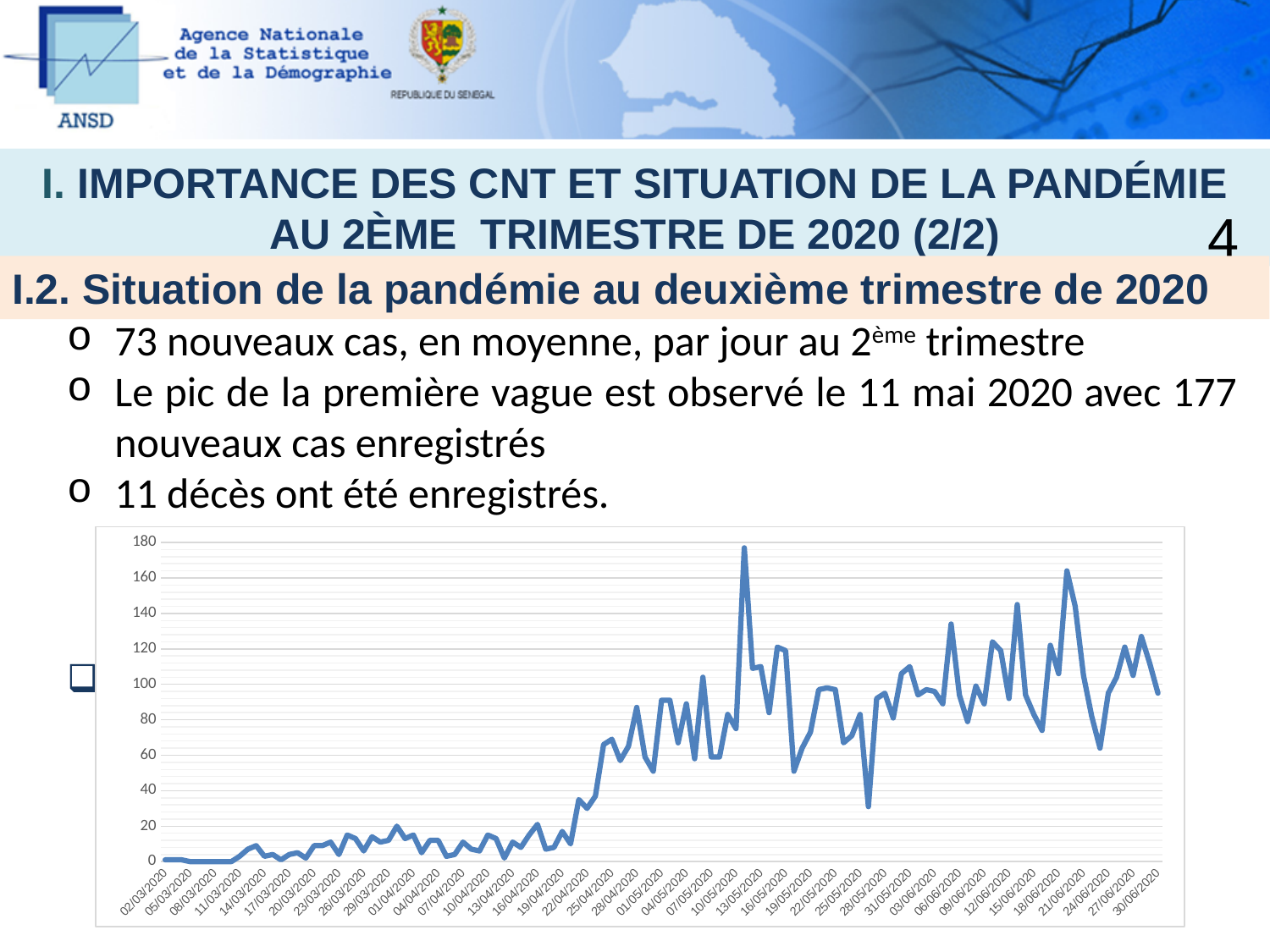
Is the highest point of the chart greater or less than 160? greater Which is higher, the peak in mid-May 2020 or the peak in late June 2020? mid-May 2020 What kind of chart is shown on the slide? line chart What is the first date shown on the horizontal axis of the chart? 02/03/2020 Is the value for 01/04/2020 greater or less than 40? less Is the value for 13/04/2020 greater or less than 20? less Overall, do the values in the chart rise or fall from March 2020 to June 2020? rise Which is larger, the value for 02/03/2020 or the value for 30/06/2020? 30/06/2020 What is the highest tick value shown on the vertical axis of the chart? 180